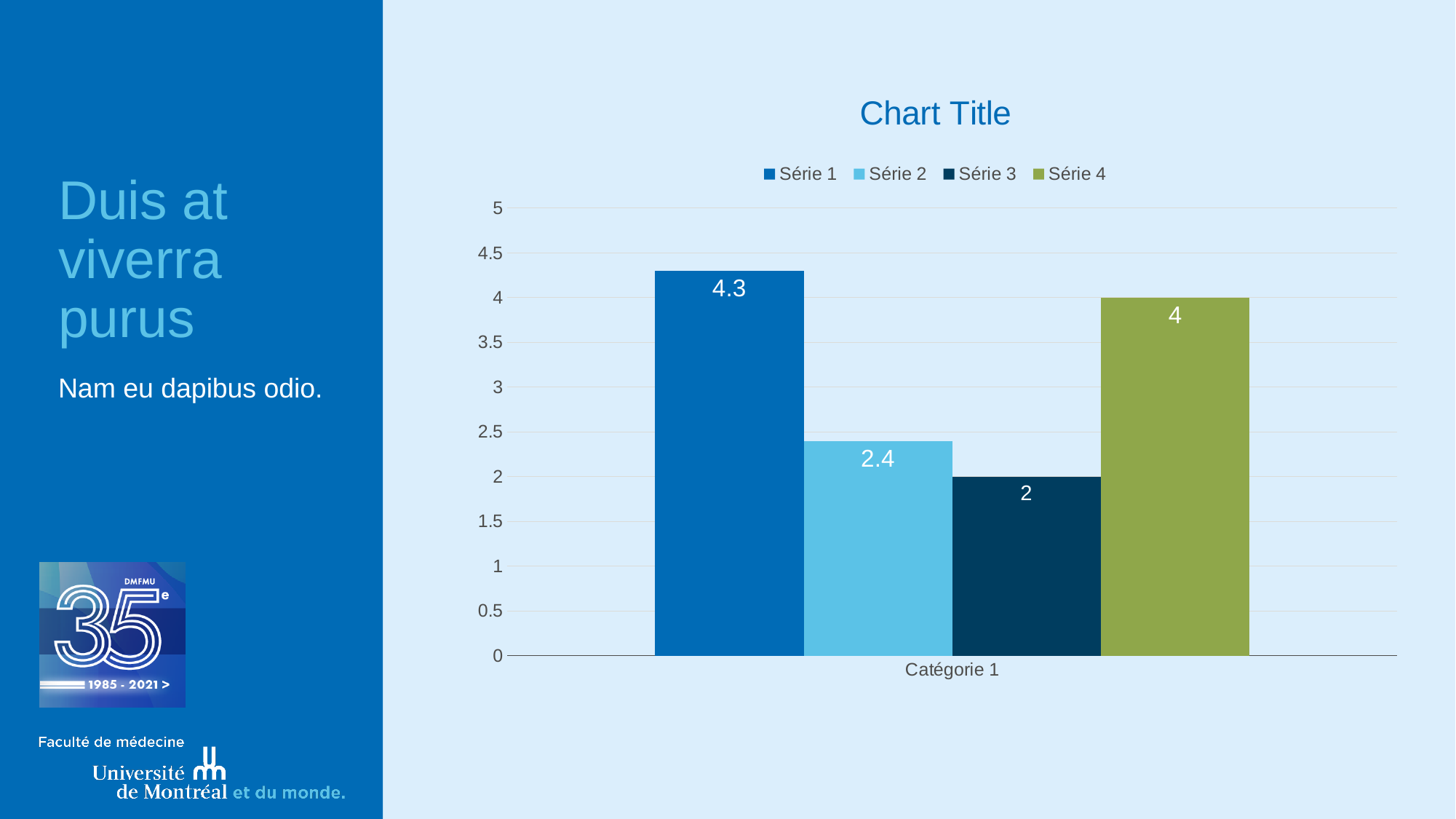
What kind of chart is shown on the slide? Bar chart What is the value for Série 3 in Catégorie 1? 2 Which series has the lowest value in Catégorie 1? Série 3 What is the value for Série 4 in Catégorie 1? 4 Which is larger, the value for Série 2 or the value for Série 4? Série 4 What is the value for Série 1 in Catégorie 1? 4.3 Which series has the highest value in Catégorie 1? Série 1 What is the difference between the values for Série 4 and Série 3? 2 How many series does the legend list? 4 What is the title of the chart? Chart Title What is the difference between the values for Série 1 and Série 2? 1.9 What is the value for Série 2 in Catégorie 1? 2.4